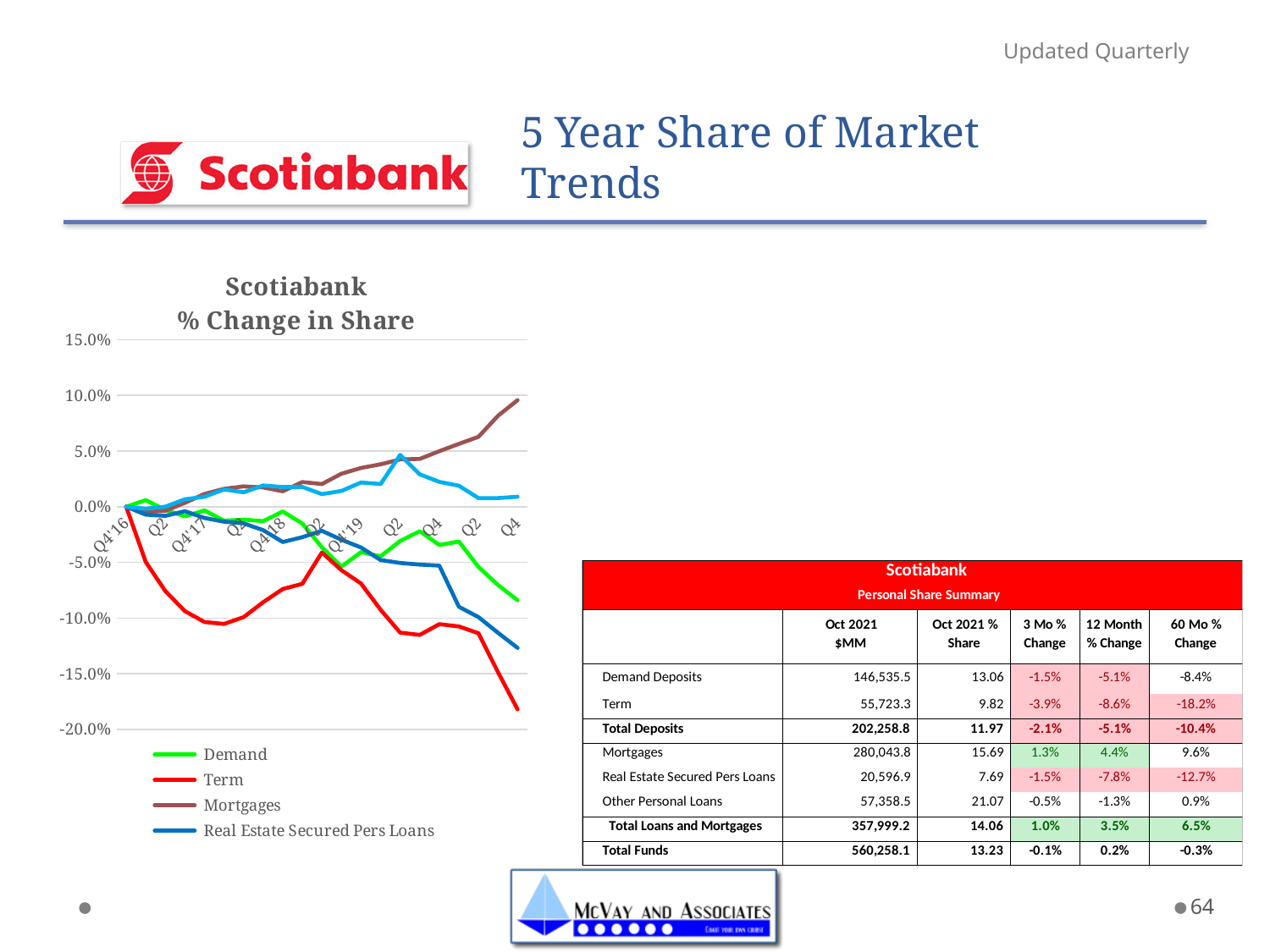
Does the Mortgages line generally rise or fall from Q4'16 to the final Q4? rise Which series has the highest value at the final Q4 point on the chart? Mortgages Does the Term line generally rise or fall from Q4'16 to the final Q4? fall What type of chart is the "Scotiabank % Change in Share" chart? line chart What is the title of the chart on the slide? Scotiabank % Change in Share At the final Q4 point, which is higher: Demand or Real Estate Secured Pers Loans? Demand Is the value for Term at the final Q4 point greater or less than -15.0%? less Is the value for Demand at the final Q4 point greater or less than -10.0%? greater How many series does the legend of the "Scotiabank % Change in Share" chart list? 4 Is the value for Mortgages at the final Q4 point greater or less than 5.0%? greater Which series has the lowest value at the final Q4 point on the chart? Term